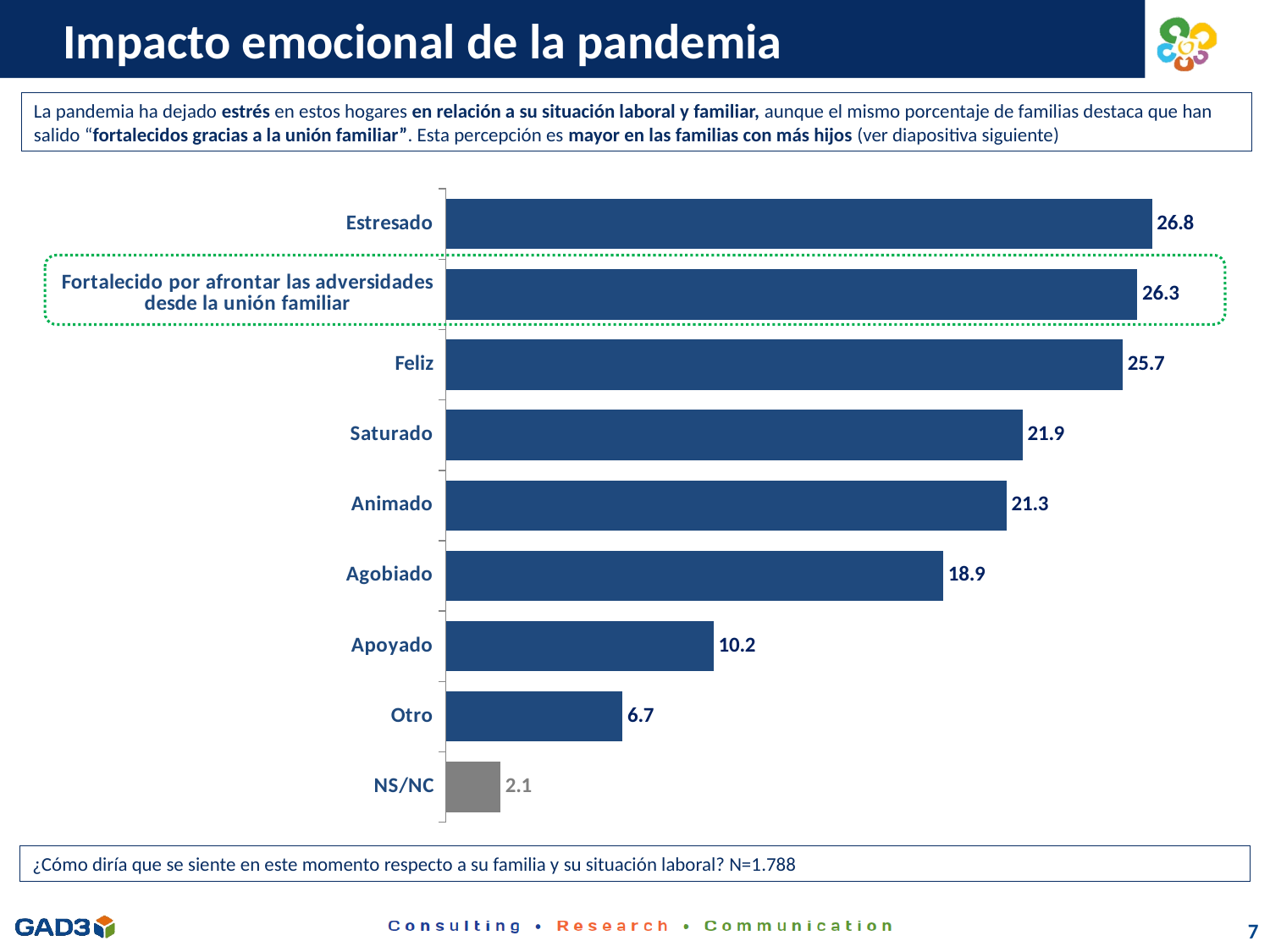
What is the value for Apoyado? 10.2 How many categories are shown in the chart? 9 Which category is highlighted with a dashed green box? Fortalecido por afrontar las adversidades desde la unión familiar What kind of chart is shown on the slide? Bar chart What is the value for NS/NC? 2.1 What is the value for Estresado? 26.8 Which category has the lowest value? NS/NC What is the difference between the values for Saturado and Animado? 0.6 Which category has the highest value? Estresado What is the difference between the values for Agobiado and Otro? 12.2 Which is larger, the value for Animado or the value for Agobiado? Animado What is the value for Feliz? 25.7